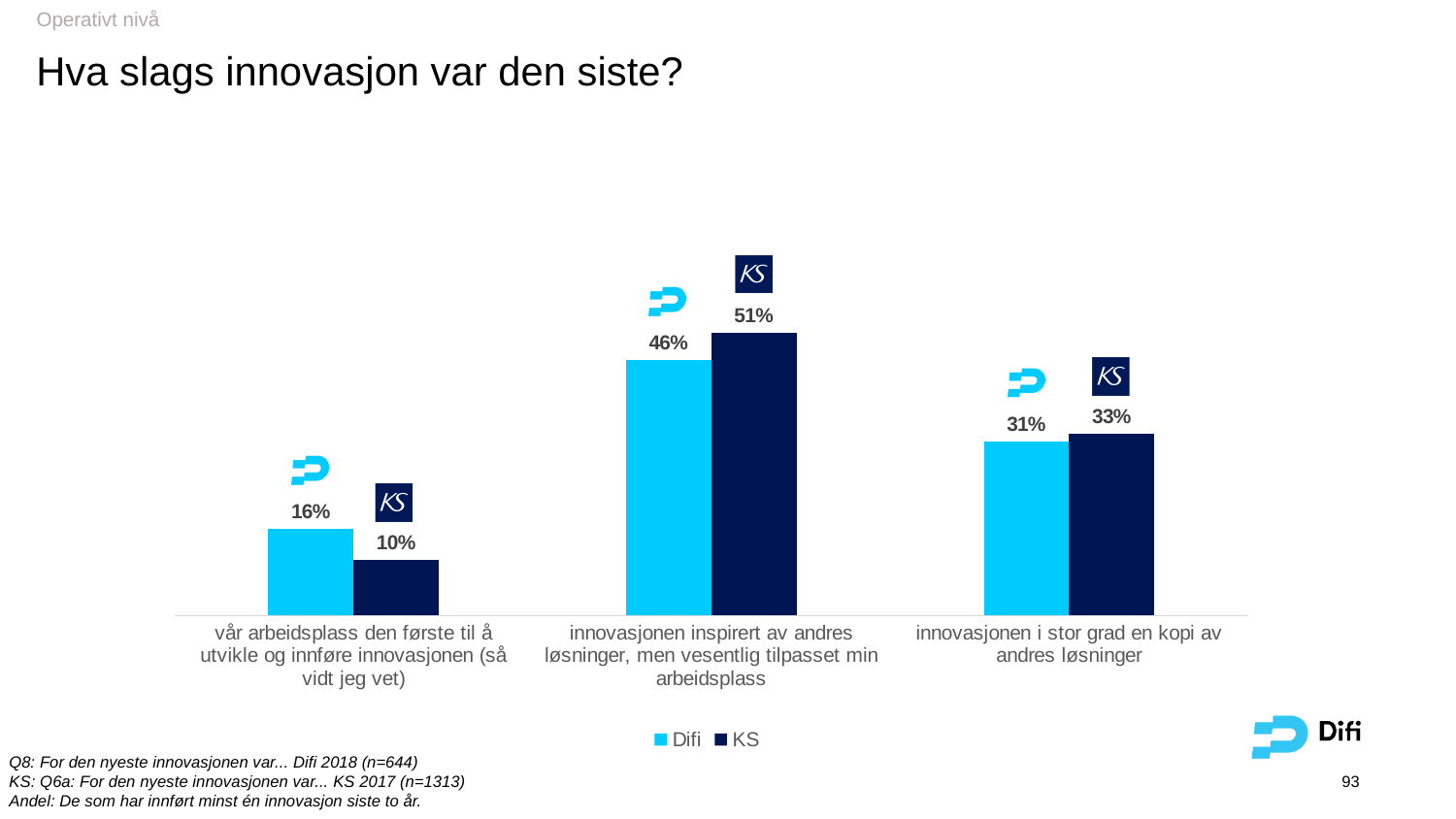
Which category has the highest KS value? innovasjonen inspirert av andres løsninger, men vesentlig tilpasset min arbeidsplass Which category has the lowest Difi value? vår arbeidsplass den første til å utvikle og innføre innovasjonen (så vidt jeg vet) For 'innovasjonen i stor grad en kopi av andres løsninger', which series has the larger value, Difi or KS? KS What is the KS value for 'innovasjonen i stor grad en kopi av andres løsninger'? 33% What kind of chart is shown on the slide? bar chart What is the difference between the KS and Difi values for 'innovasjonen inspirert av andres løsninger, men vesentlig tilpasset min arbeidsplass'? 5% What is the KS value for 'vår arbeidsplass den første til å utvikle og innføre innovasjonen (så vidt jeg vet)'? 10% How many series does the legend list? 2 What is the Difi value for 'innovasjonen inspirert av andres løsninger, men vesentlig tilpasset min arbeidsplass'? 46% For 'vår arbeidsplass den første til å utvikle og innføre innovasjonen (så vidt jeg vet)', which series has the larger value, Difi or KS? Difi How many categories are shown on the x axis? 3 What is the difference between the Difi and KS values for 'vår arbeidsplass den første til å utvikle og innføre innovasjonen (så vidt jeg vet)'? 6%